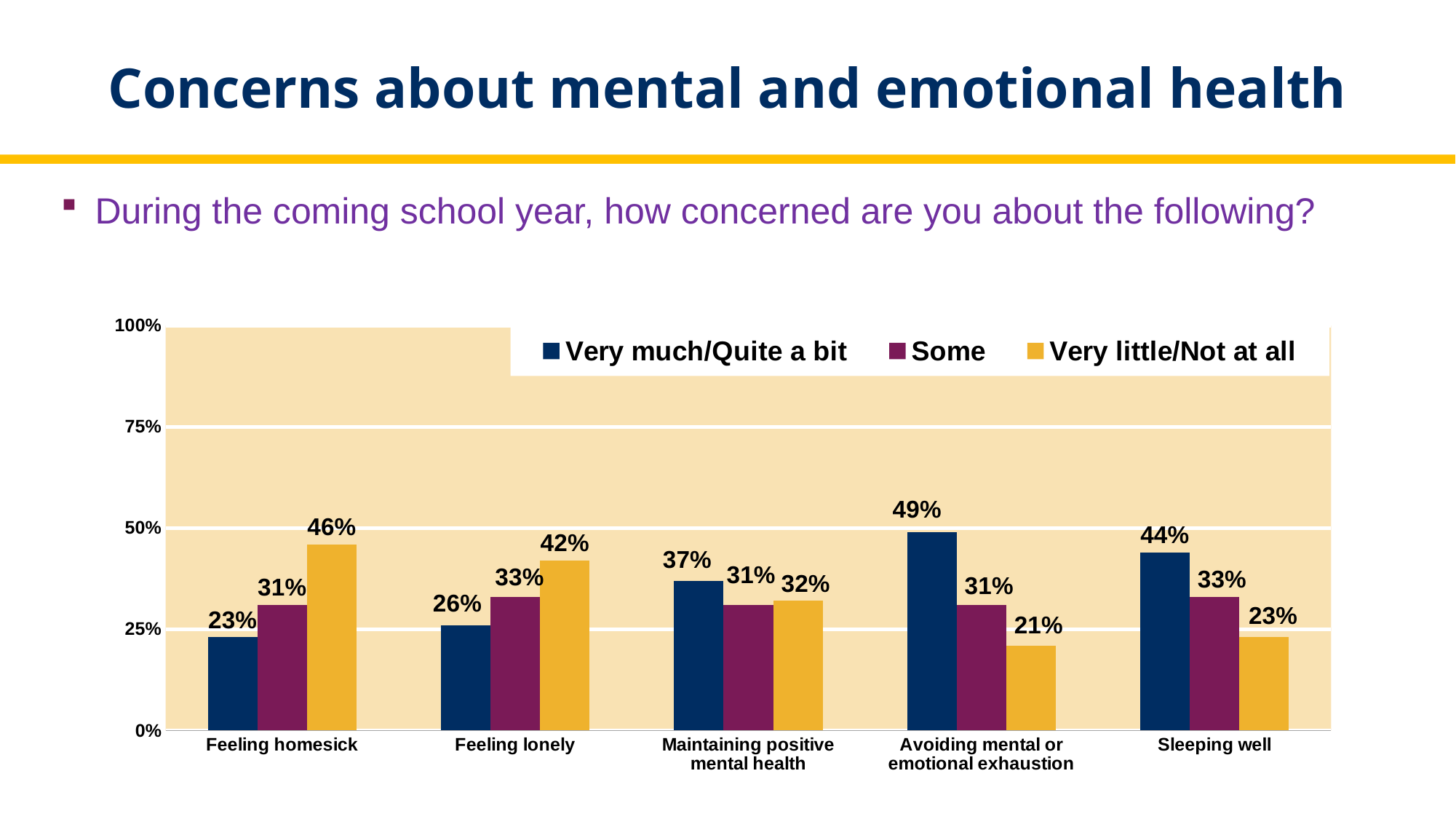
Which category has the highest 'Very much/Quite a bit' value? Avoiding mental or emotional exhaustion What is the difference between the 'Very little/Not at all' and 'Very much/Quite a bit' values for feeling homesick? 23% What percentage of respondents are concerned 'Very much/Quite a bit' about feeling homesick? 23% Is the 'Very much/Quite a bit' value for sleeping well greater or less than 25%? greater Which legend entry is shown in yellow? Very little/Not at all Which category has the lowest 'Very little/Not at all' value? Avoiding mental or emotional exhaustion How many series does the legend list? 3 How many categories are shown on the x axis? 5 For maintaining positive mental health, which is larger: the 'Very much/Quite a bit' value or the 'Very little/Not at all' value? Very much/Quite a bit What is the 'Some' value for sleeping well? 33% What kind of chart is shown on the slide? Bar chart What is the 'Very little/Not at all' value for feeling lonely? 42%